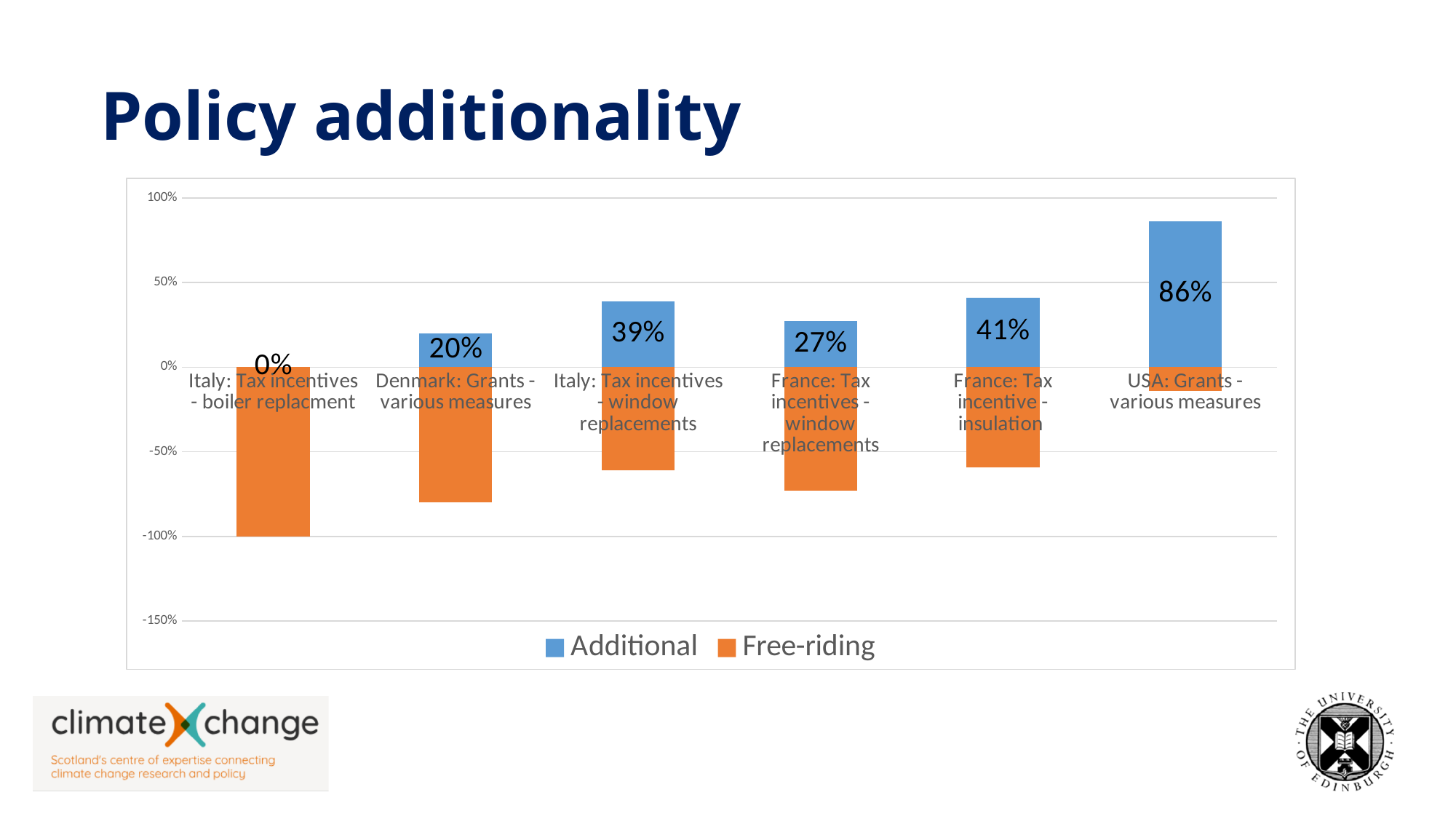
What is the Additional value for Denmark: Grants - various measures? 20% What is the difference between the Additional values for France: Tax incentive - insulation and France: Tax incentives - window replacements? 14% Which policy has the lowest Additional value? Italy: Tax incentives - boiler replacment How many policies are shown on the x axis? 6 Which colour represents the Free-riding series? Orange How many series does the legend list? 2 Which policy has the highest Additional value? USA: Grants - various measures What kind of chart is shown on the slide? Stacked bar chart What is the Additional value for France: Tax incentive - insulation? 41% What is the Additional value for USA: Grants - various measures? 86% Is the Free-riding value for Denmark: Grants - various measures greater or less than -50%? less Which has a larger Additional value, Italy: Tax incentives - window replacements or Denmark: Grants - various measures? Italy: Tax incentives - window replacements